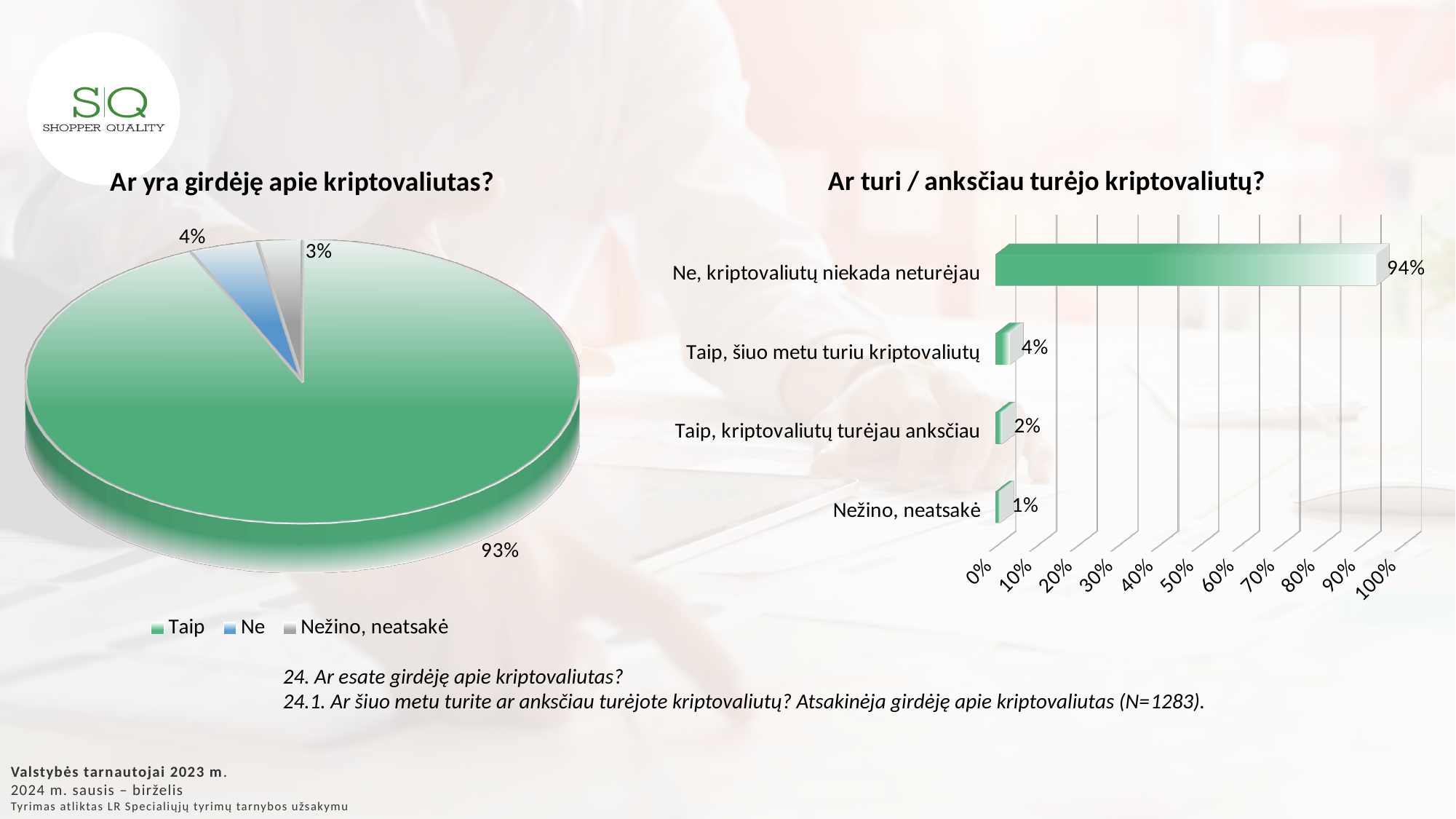
In the bar chart 'Ar turi / anksčiau turėjo kriptovaliutų?', what is the value for 'Ne, kriptovaliutų niekada neturėjau'? 94% In the pie chart 'Ar yra girdėję apie kriptovaliutas?', what share is 'Nežino, neatsakė'? 3% What type of chart is the left chart 'Ar yra girdėję apie kriptovaliutas?'? Pie chart In the bar chart 'Ar turi / anksčiau turėjo kriptovaliutų?', how many categories are shown? 4 In the pie chart 'Ar yra girdėję apie kriptovaliutas?', which category has the largest slice? Taip What type of chart is the right chart 'Ar turi / anksčiau turėjo kriptovaliutų?'? Bar chart In the pie chart 'Ar yra girdėję apie kriptovaliutas?', what share of respondents answered 'Ne'? 4% In the bar chart 'Ar turi / anksčiau turėjo kriptovaliutų?', what is the difference between 'Taip, šiuo metu turiu kriptovaliutų' and 'Taip, kriptovaliutų turėjau anksčiau'? 2% In the bar chart 'Ar turi / anksčiau turėjo kriptovaliutų?', which category has the lowest value? Nežino, neatsakė In the pie chart 'Ar yra girdėję apie kriptovaliutas?', how many categories does the legend list? 3 In the bar chart 'Ar turi / anksčiau turėjo kriptovaliutų?', what is the value for 'Taip, šiuo metu turiu kriptovaliutų'? 4% In the pie chart 'Ar yra girdėję apie kriptovaliutas?', what share of respondents answered 'Taip'? 93%